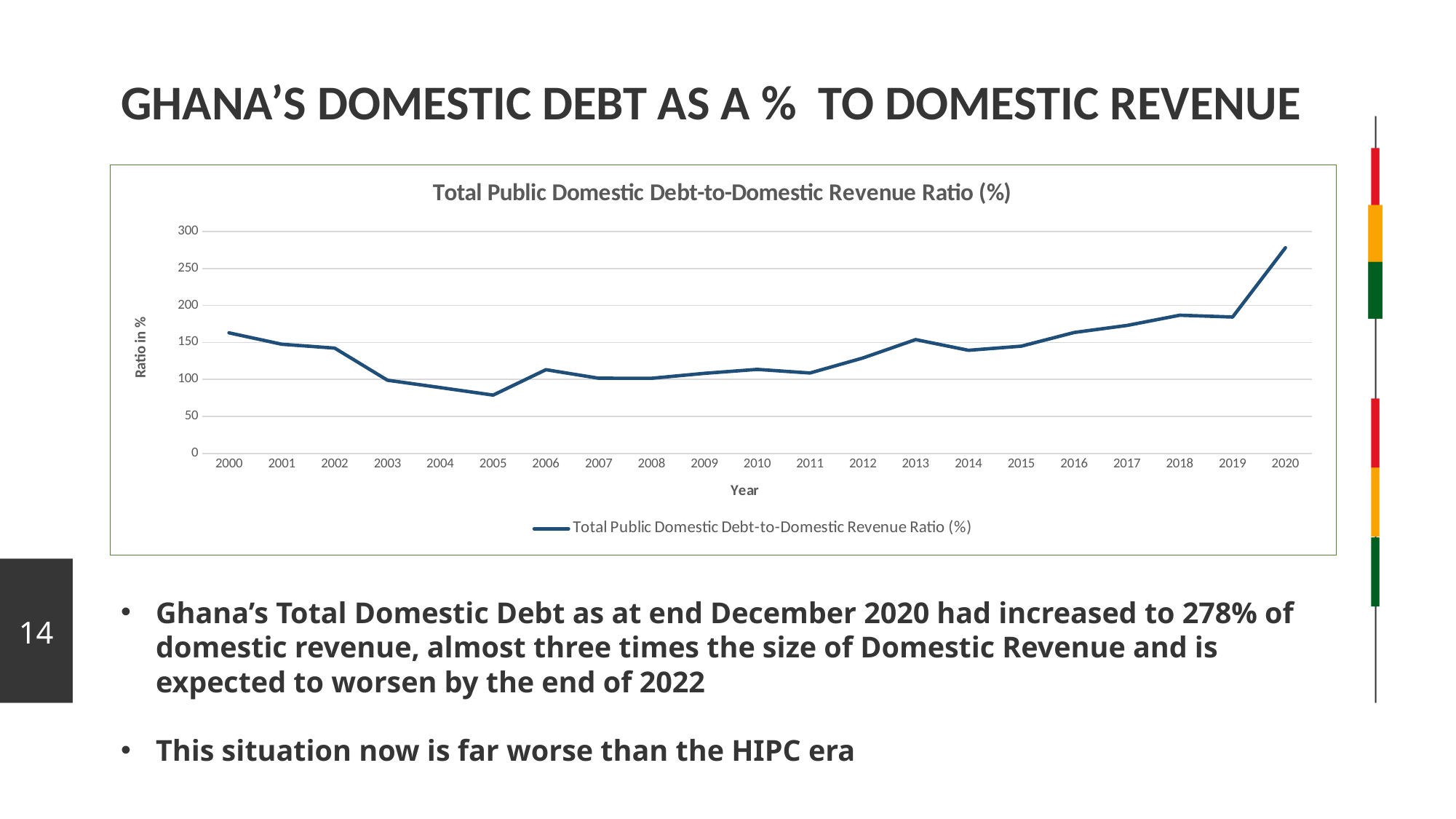
Is the value for 2018 greater or less than 200? less Which year has the larger ratio, 2013 or 2014? 2013 In which year is the debt-to-revenue ratio highest? 2020 How many years are plotted along the x axis of the chart? 21 Is the value for 2005 greater or less than 100? less Is the value for 2020 greater or less than 250? greater How many series does the chart's legend list? 1 What is the title of the chart? Total Public Domestic Debt-to-Domestic Revenue Ratio (%) What is the label on the vertical axis of the chart? Ratio in % Does the ratio rise or fall between 2000 and 2005? fall In which year is the debt-to-revenue ratio lowest? 2005 What kind of chart is shown on the slide? line chart